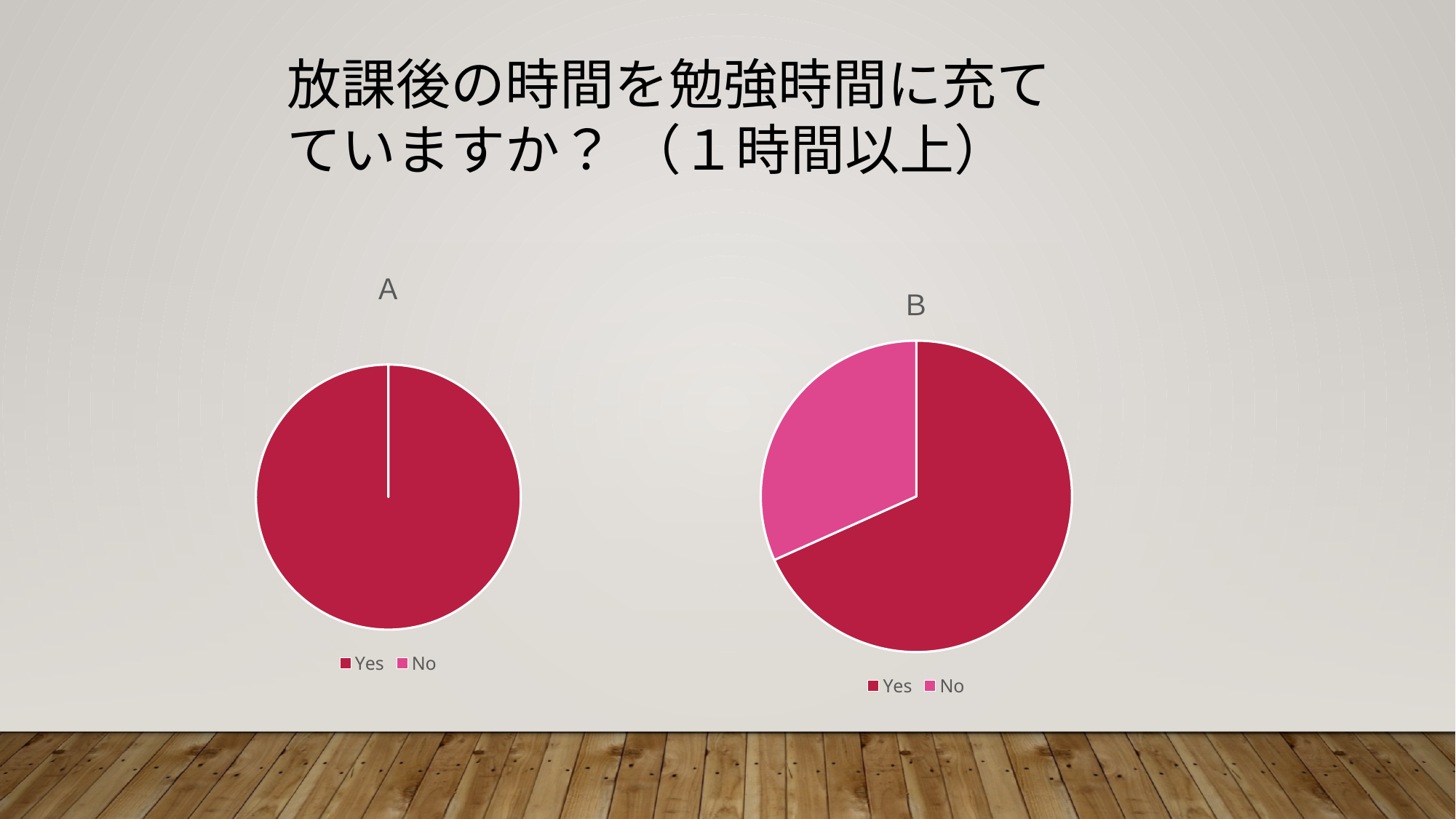
In the chart titled A, which category has the largest slice? Yes What is the title of the pie chart on the left side of the slide? A In the chart titled B, which slice is larger, Yes or No? Yes How many pie charts are shown on the slide? 2 In the chart titled B, which category has the smallest slice? No How many entries does the legend of the chart titled A list? 2 What kind of chart is the chart titled B? pie chart What kind of chart is the chart titled A? pie chart How many entries does the legend of the chart titled B list? 2 What are the legend entries of the chart titled B? Yes, No In the chart titled B, which category has the largest slice? Yes